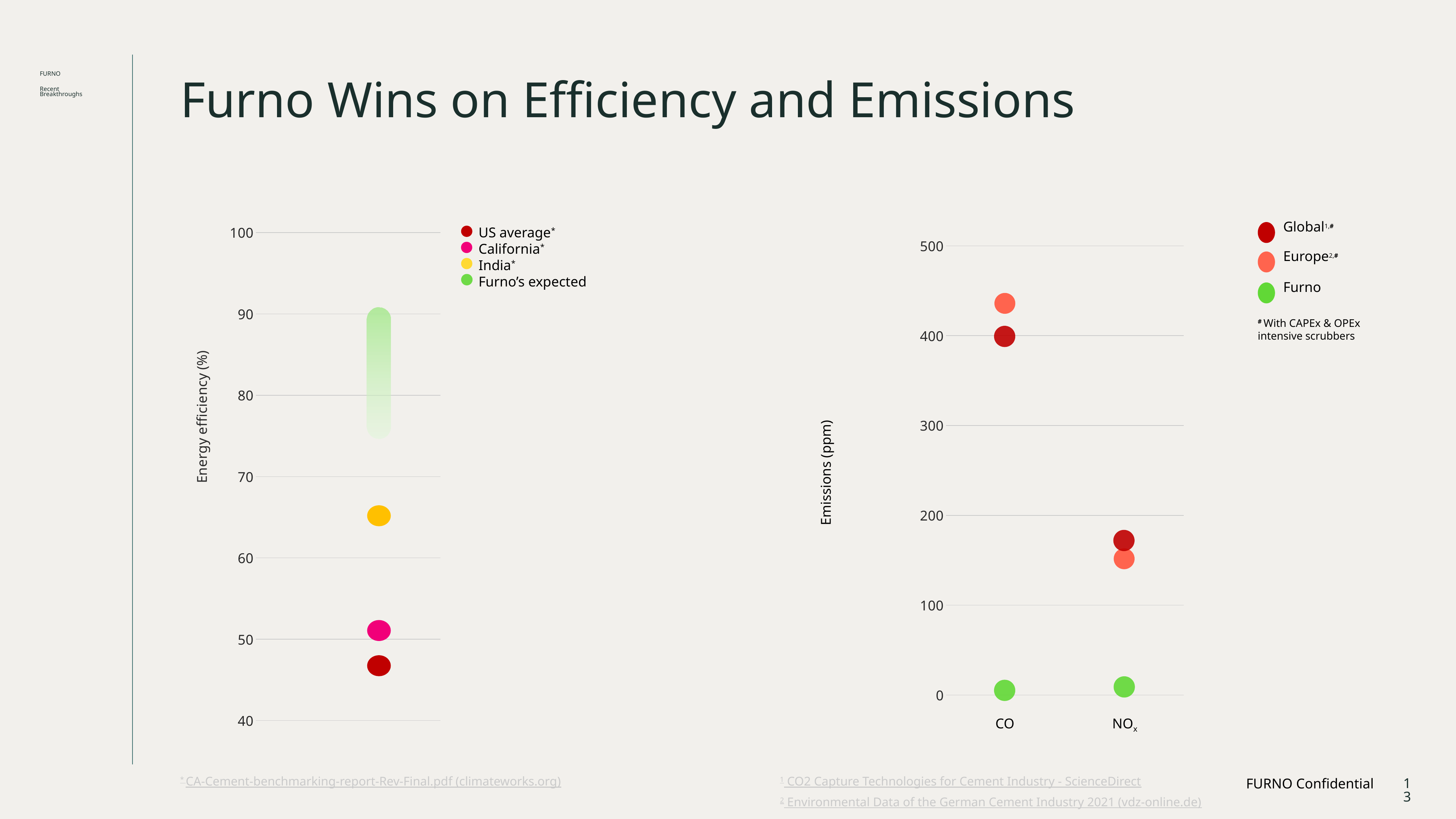
On the right chart (Emissions), which series has the highest CO emissions? Europe On the right chart (Emissions), how many categories are shown on the x axis? 2 On the right chart (Emissions), how many series does the legend list? 3 On the right chart (Emissions), which series has the lowest NOx emissions? Furno On the left chart (Energy efficiency), is the value for California greater or less than 60? less On the right chart (Emissions), is the Europe value for CO greater or less than 400? greater On the right chart (Emissions), what is the y-axis title? Emissions (ppm) On the left chart (Energy efficiency), is the value for India greater or less than 60? greater On the left chart (Energy efficiency), which of the three plotted regions has the highest energy efficiency? India On the left chart (Energy efficiency), which region has the lowest energy efficiency? US average On the left chart (Energy efficiency), how many entries does the legend list? 4